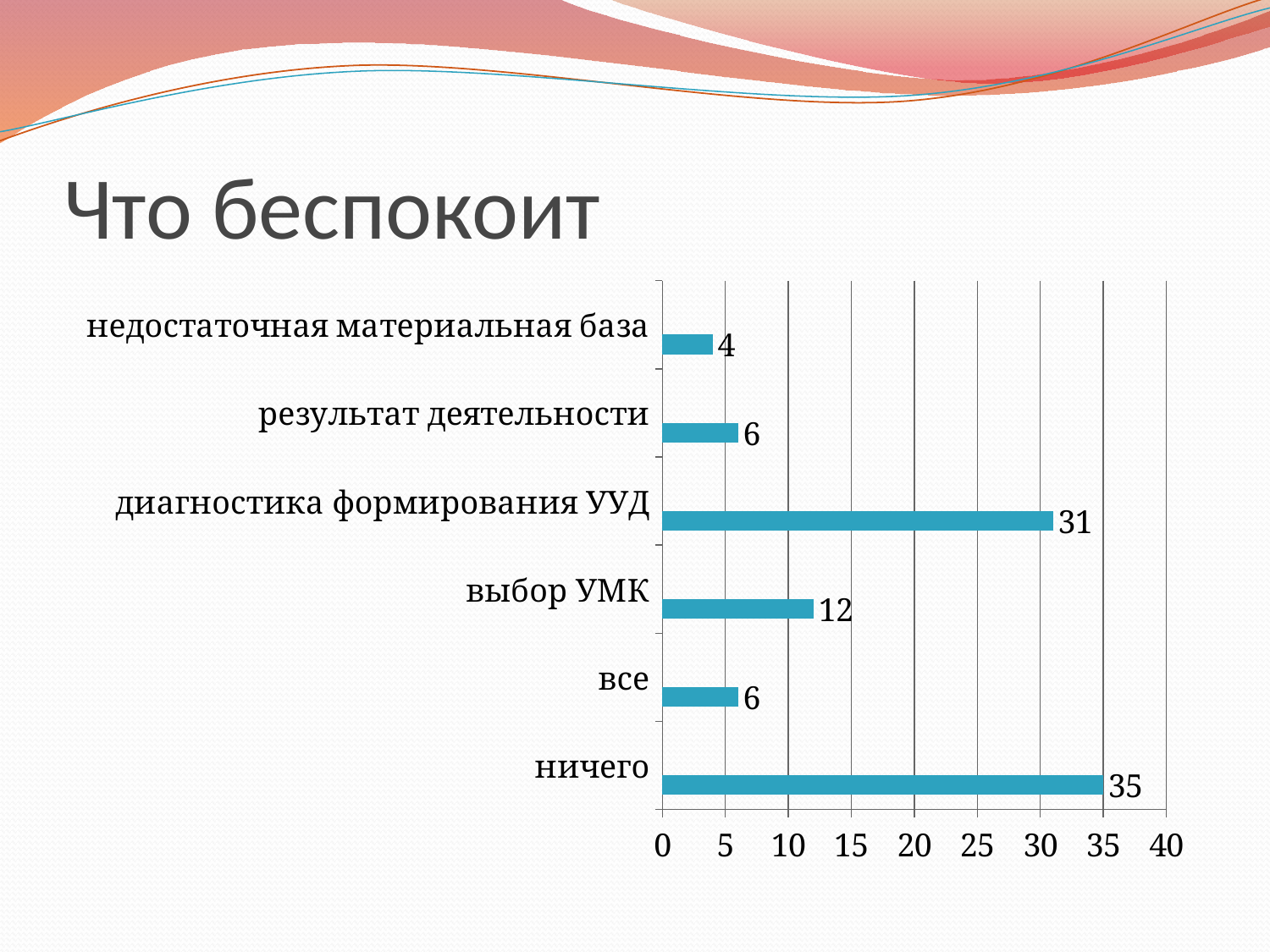
What is the value for "ничего"? 35 What is the value for "недостаточная материальная база"? 4 What kind of chart is shown on the slide? bar chart Which category has the lowest value? недостаточная материальная база What is the difference between the values for "выбор УМК" and "все"? 6 What is the title of the slide? Что беспокоит What is the value for "диагностика формирования УУД"? 31 Which is larger, the value for "выбор УМК" or the value for "результат деятельности"? выбор УМК What is the value for "выбор УМК"? 12 Which category has the highest value? ничего What is the difference between the values for "ничего" and "диагностика формирования УУД"? 4 How many categories are shown in the chart? 6